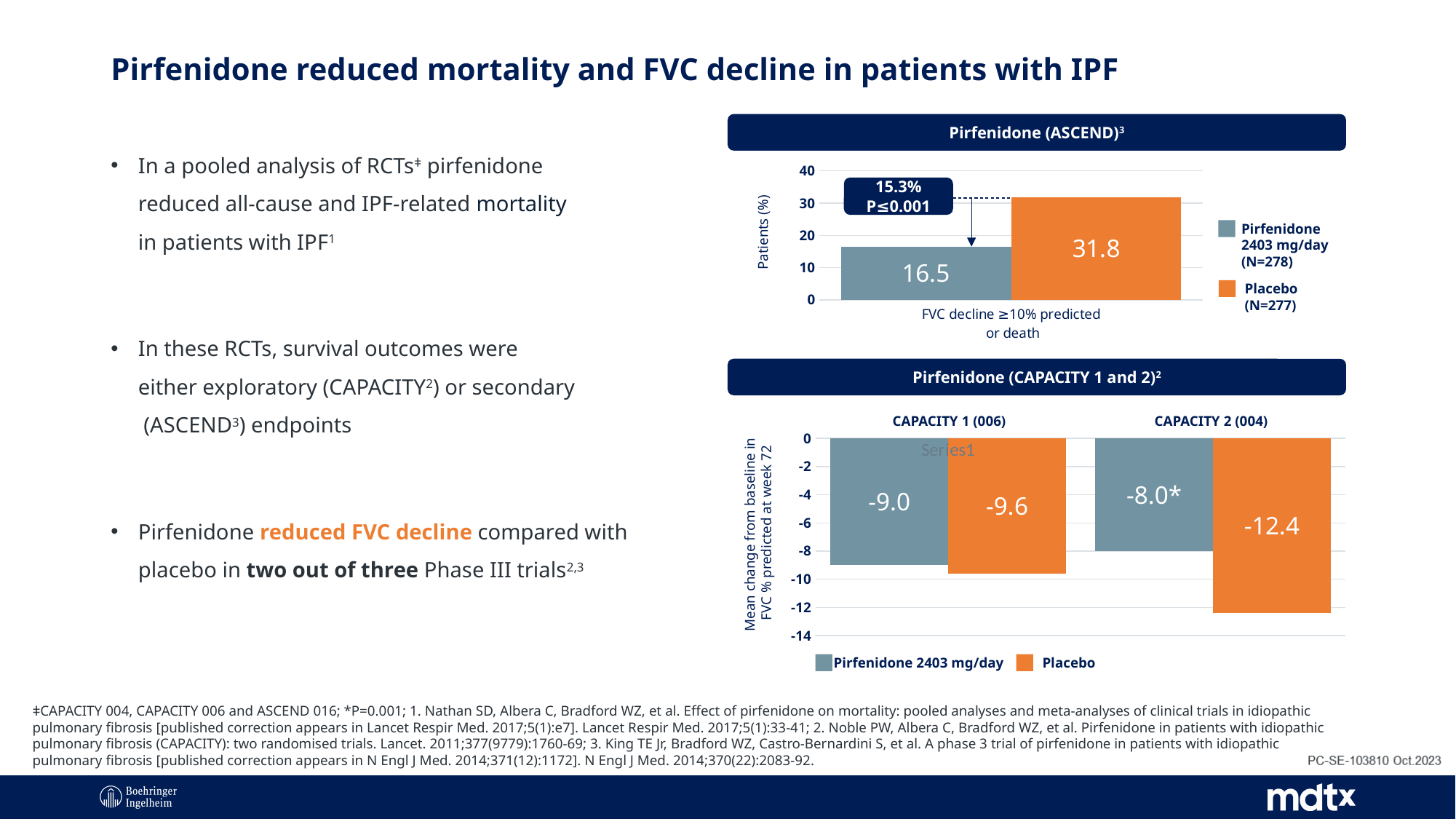
In the Pirfenidone (ASCEND) chart, how many patients were in the placebo group according to the legend? N=277 In the Pirfenidone (CAPACITY 1 and 2) chart, what is the value for pirfenidone in CAPACITY 2 (004)? -8.0* In the Pirfenidone (ASCEND) chart, what is the value for the placebo group? 31.8 In the Pirfenidone (CAPACITY 1 and 2) chart, what is the mean change from baseline in FVC % predicted for pirfenidone in CAPACITY 1 (006)? -9.0 In the Pirfenidone (ASCEND) chart, what is the difference between the placebo and pirfenidone values? 15.3 How many series does the legend of the Pirfenidone (CAPACITY 1 and 2) chart list? 2 In the Pirfenidone (ASCEND) chart, what percentage of patients in the pirfenidone group had FVC decline ≥10% predicted or death? 16.5 What type of chart is the Pirfenidone (ASCEND) chart? Bar chart In the Pirfenidone (CAPACITY 1 and 2) chart, what is the value for placebo in CAPACITY 2 (004)? -12.4 In the Pirfenidone (CAPACITY 1 and 2) chart, what is the difference between the placebo and pirfenidone values in CAPACITY 2 (004)? 4.4 In the Pirfenidone (ASCEND) chart, which group has the higher value, pirfenidone or placebo? Placebo In the Pirfenidone (CAPACITY 1 and 2) chart, which bar shows the largest decline in FVC % predicted? Placebo in CAPACITY 2 (004)